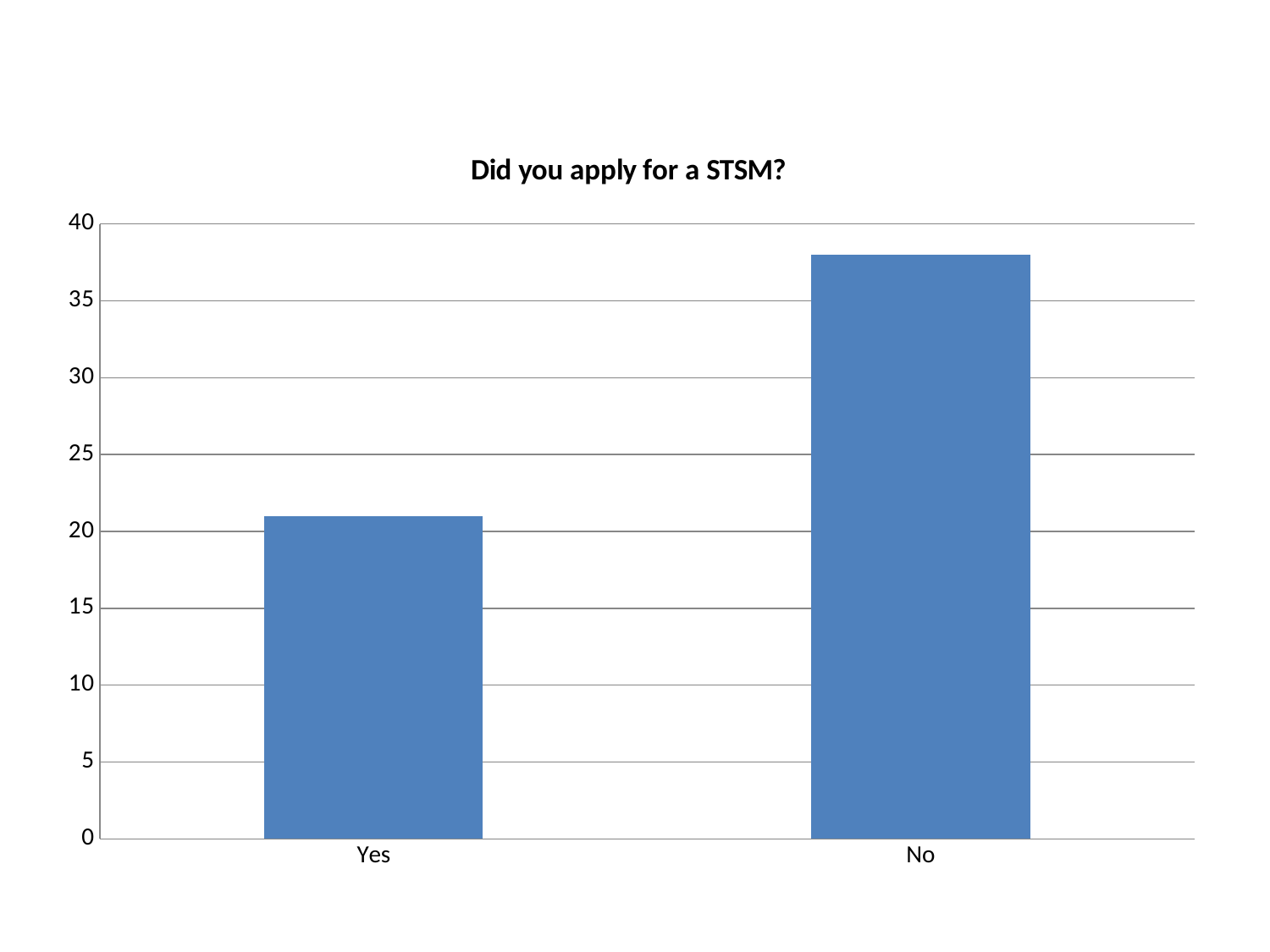
What is the highest value shown on the y axis? 40 What is the title of the chart? Did you apply for a STSM? Which category has the lowest value? Yes What kind of chart is shown on the slide? bar chart Which is larger, the value for Yes or the value for No? No Which category has the highest value? No Is the value for No greater or less than 40? less How many categories are shown on the x axis? 2 Is the value for No greater or less than 35? greater Is the value for Yes greater or less than 20? greater